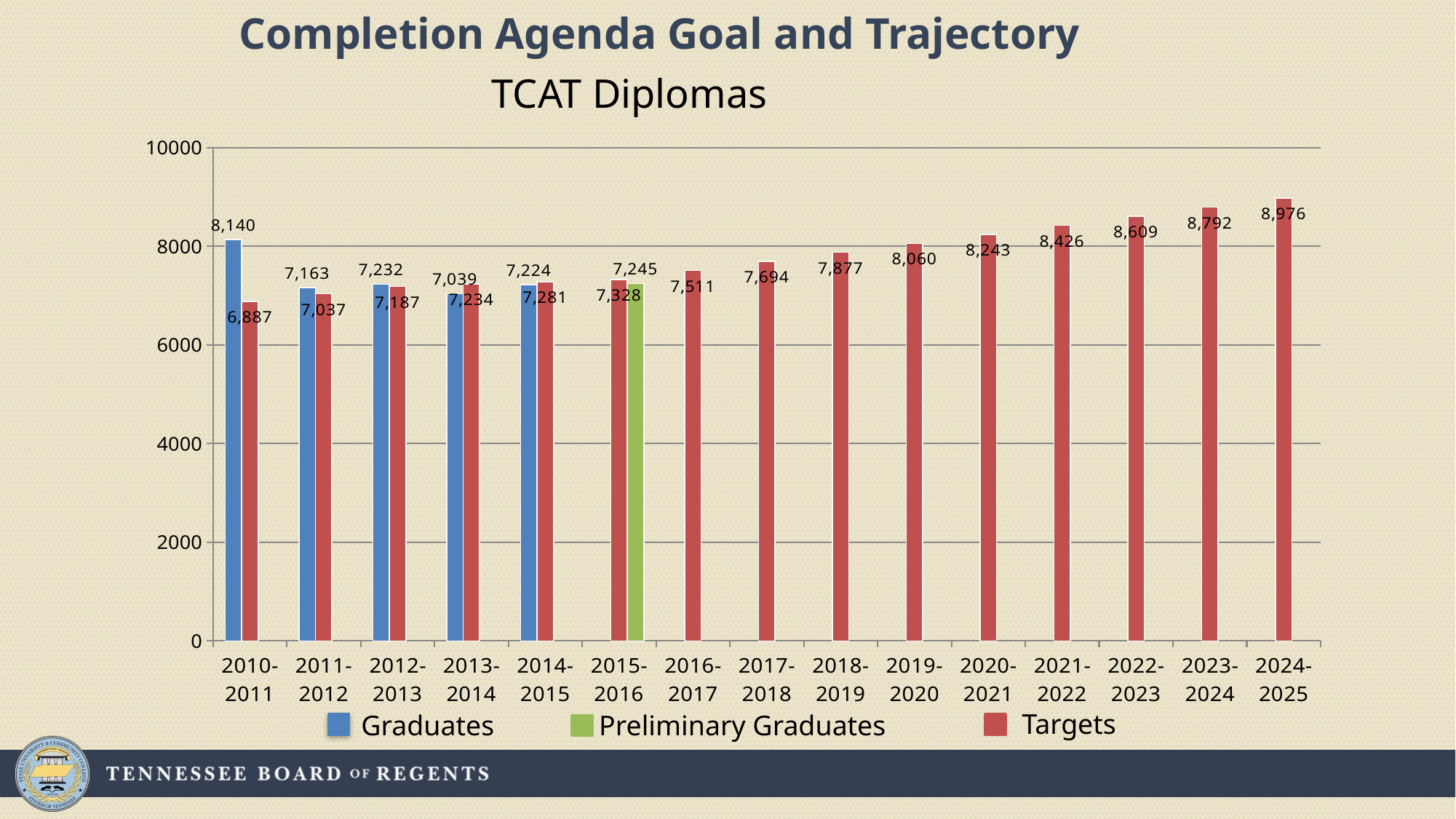
What kind of chart is shown on the slide? bar chart What is the Preliminary Graduates value for 2015-2016? 7,245 How many series does the legend list? 3 Which year has the lowest Targets value? 2010-2011 Do the Targets values rise or fall from 2010-2011 to 2024-2025? rise What is the Targets value for 2019-2020? 8,060 What is the Targets value for 2024-2025? 8,976 How many academic years are shown on the x axis? 15 In 2013-2014, which is larger, the Graduates value or the Targets value? Targets What is the difference between the Graduates value and the Targets value in 2010-2011? 1,253 What is the Graduates value for 2010-2011? 8,140 Which year has the highest Graduates value? 2010-2011